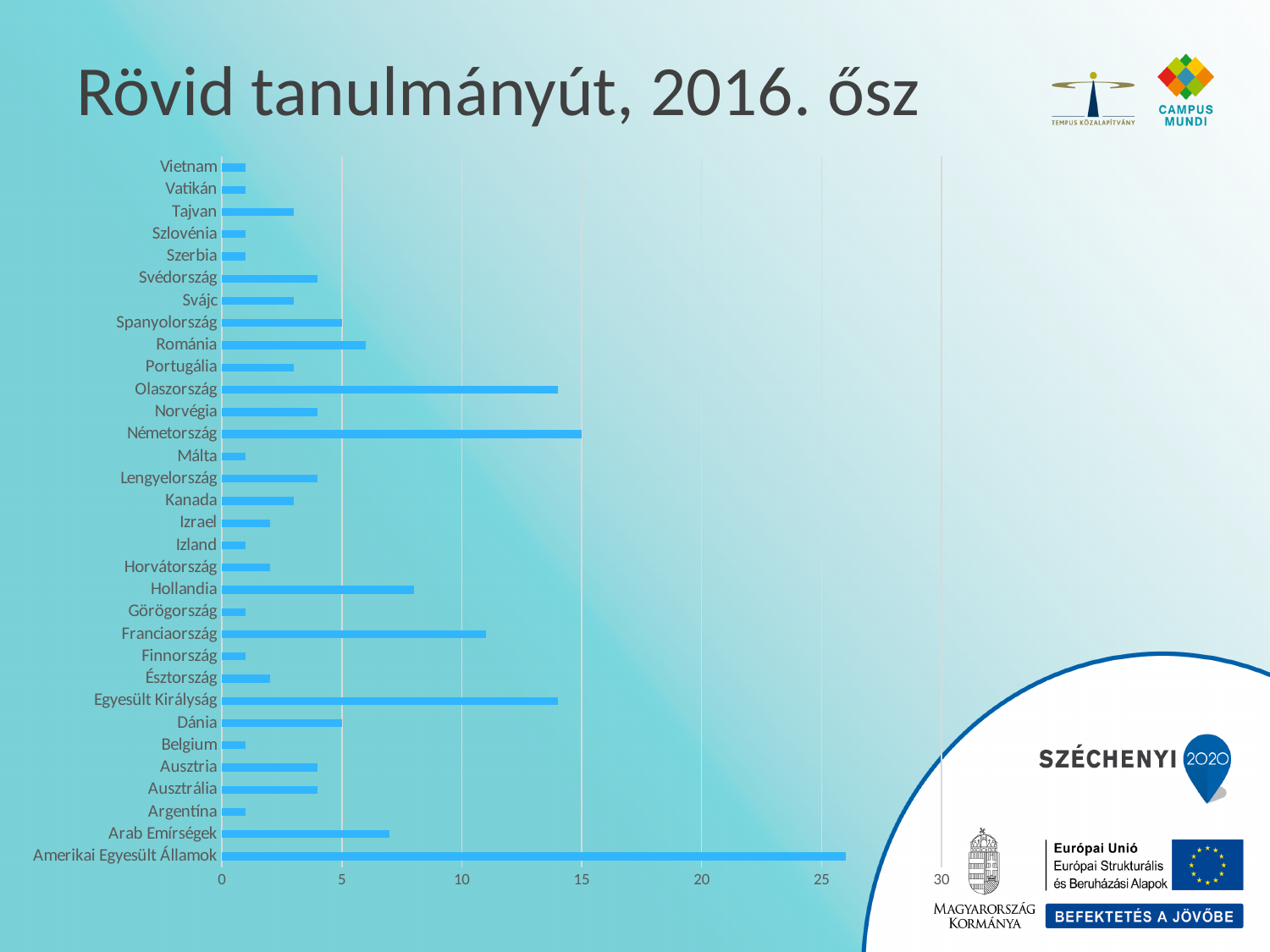
Is the value for Tajvan greater or less than 5? less Is the value for Arab Emírségek greater or less than 5? greater What kind of chart is shown on the slide? bar chart Is the value for Amerikai Egyesült Államok greater or less than 25? greater What is the title of the chart on the slide? Rövid tanulmányút, 2016. ősz Which has a larger value, Arab Emírségek or Franciaország? Franciaország Which country has the highest value on the chart? Amerikai Egyesült Államok How many countries are listed on the chart? 32 Which has a larger value, Franciaország or Hollandia? Franciaország